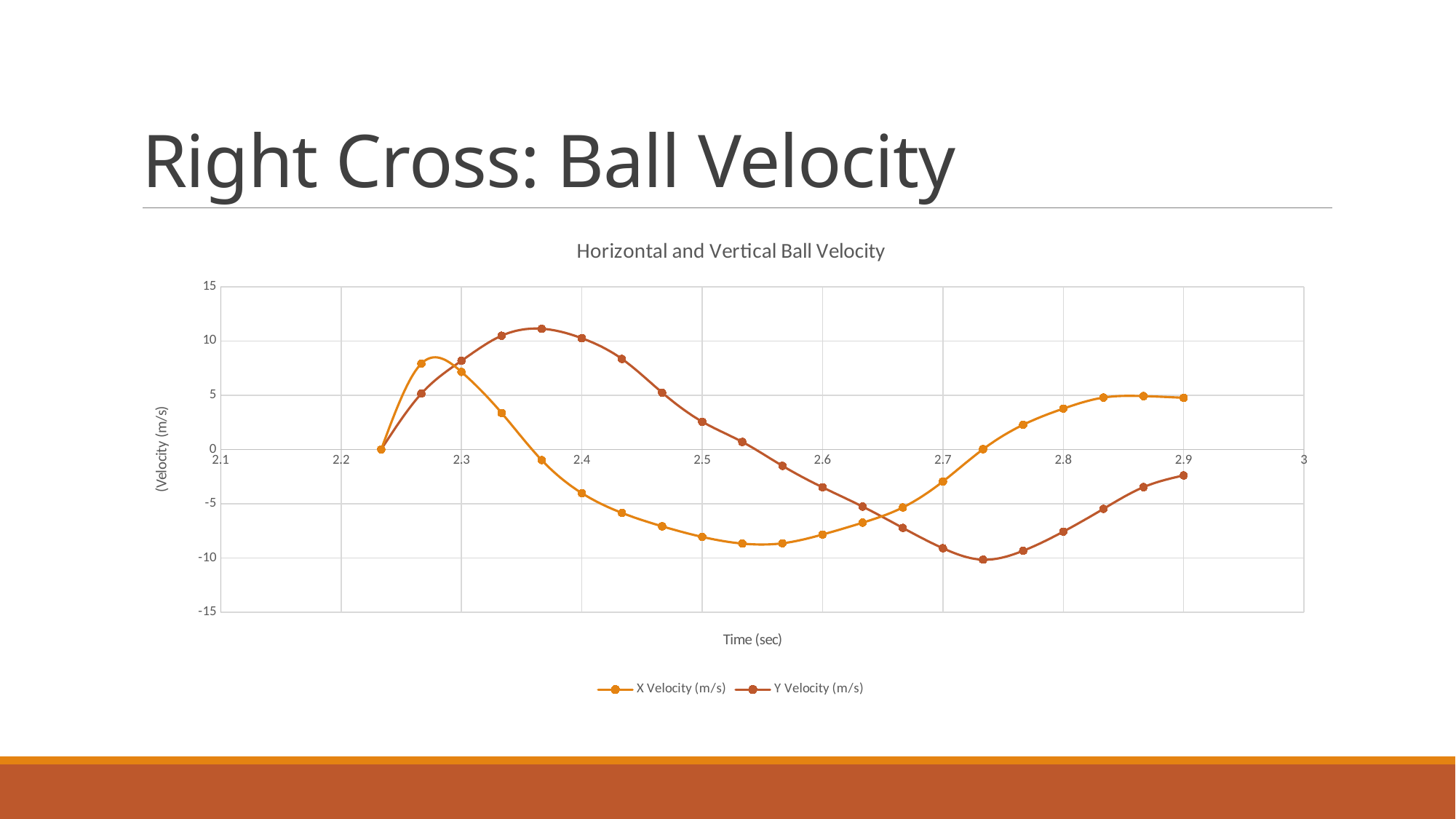
Does the X Velocity (m/s) series rise or fall between time 2.3 and time 2.5? fall What is the title of the chart? Horizontal and Vertical Ball Velocity What is the label of the x axis? Time (sec) Is the Y Velocity (m/s) value at time 2.7 greater or less than -5? less At time 2.5, which series has the larger value, X Velocity (m/s) or Y Velocity (m/s)? Y Velocity (m/s) Which series reaches the highest value on the chart? Y Velocity (m/s) How many series does the legend list? 2 What kind of chart is shown on the slide? line chart Is the X Velocity (m/s) value at time 2.8 greater or less than 0? greater At time 2.7, which series has the larger value, X Velocity (m/s) or Y Velocity (m/s)? X Velocity (m/s) Is the X Velocity (m/s) value at time 2.5 greater or less than -5? less